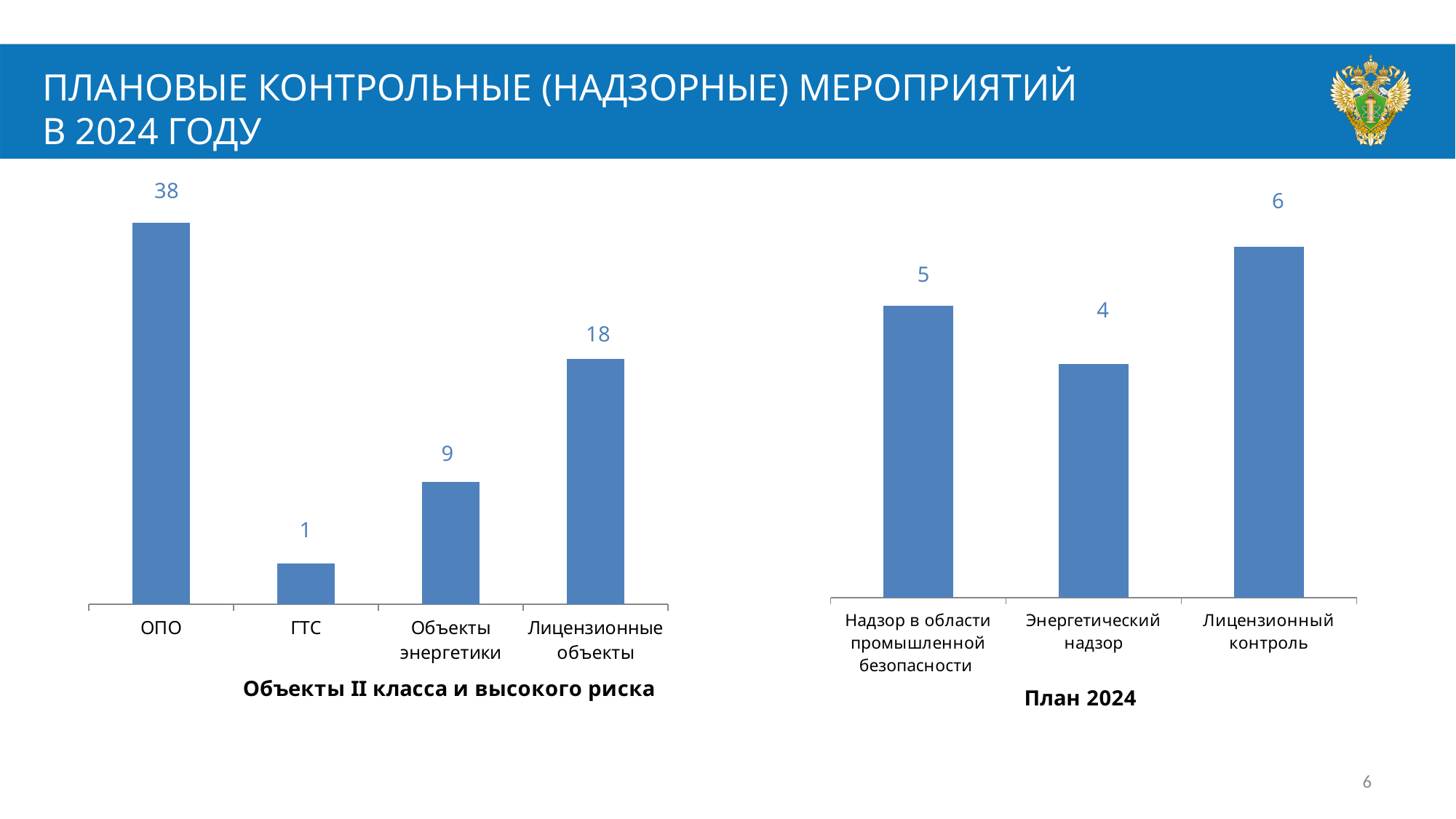
In the left chart 'Объекты II класса и высокого риска', how many categories are shown? 4 In the left chart 'Объекты II класса и высокого риска', what is the difference between the values for ОПО and Объекты энергетики? 29 In the right chart 'План 2024', what is the value for Энергетический надзор? 4 In the left chart 'Объекты II класса и высокого риска', which category has the highest value? ОПО In the left chart 'Объекты II класса и высокого риска', what is the value for Лицензионные объекты? 18 In the left chart 'Объекты II класса и высокого риска', what is the value for ОПО? 38 In the left chart 'Объекты II класса и высокого риска', which category has the lowest value? ГТС In the right chart 'План 2024', what is the value for Надзор в области промышленной безопасности? 5 What kind of chart is the right chart 'План 2024'? Bar chart In the right chart 'План 2024', which category has the highest value? Лицензионный контроль In the right chart 'План 2024', which is larger: Надзор в области промышленной безопасности or Энергетический надзор? Надзор в области промышленной безопасности In the right chart 'План 2024', what is the difference between Лицензионный контроль and Энергетический надзор? 2